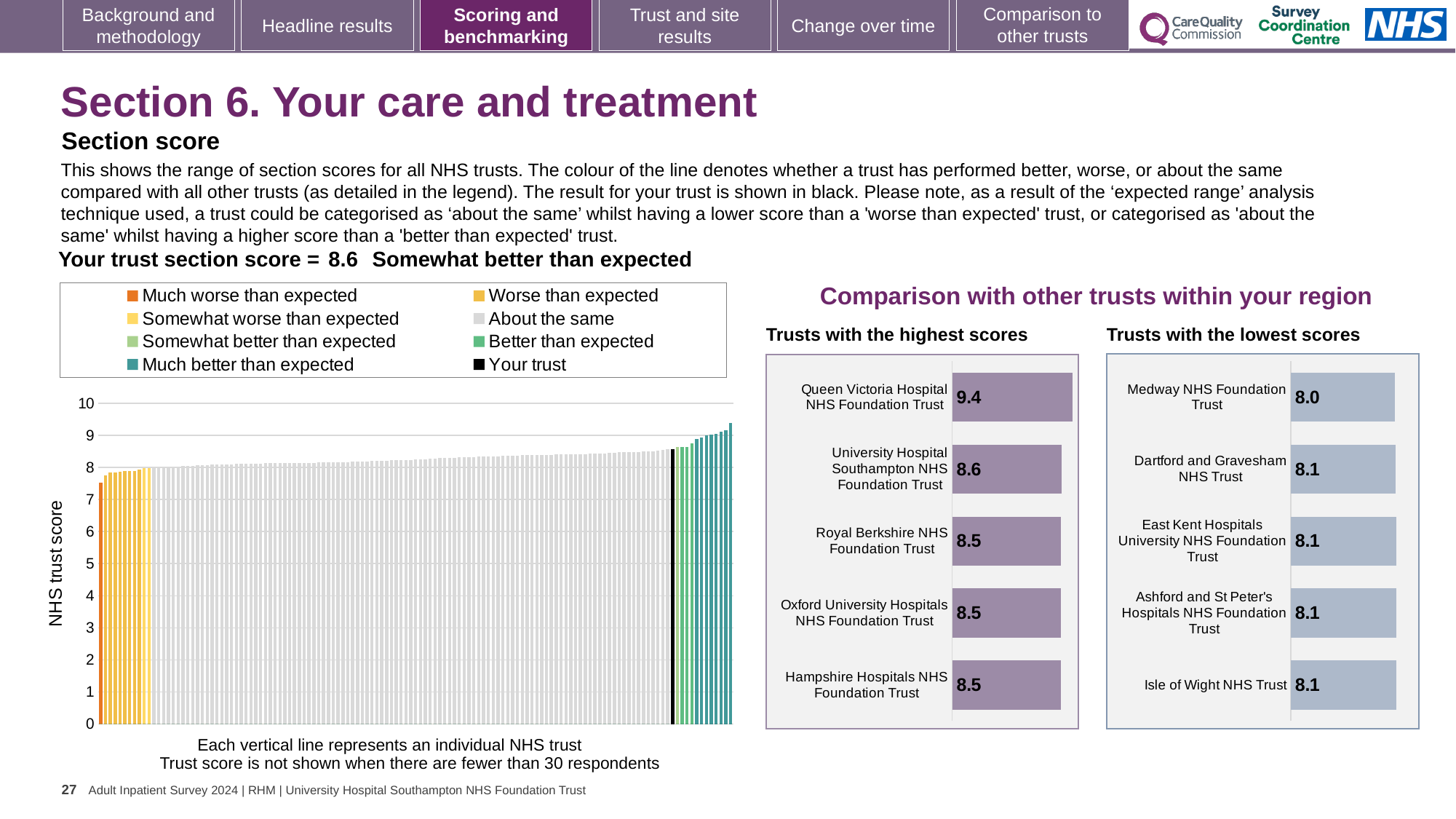
In the 'Trusts with the highest scores' chart, which trust has the highest score? Queen Victoria Hospital NHS Foundation Trust In the 'Trusts with the highest scores' chart, what is the score for Queen Victoria Hospital NHS Foundation Trust? 9.4 In the 'Trusts with the lowest scores' chart, which trust has the lowest score? Medway NHS Foundation Trust How many entries does the legend of the large chart on the left list? 8 In the large chart on the left, do the bar values rise or fall from left to right along the x axis? rise In the large chart on the left, is the value of the highest (rightmost) bar greater or less than 9? greater How many trusts are listed in the 'Trusts with the highest scores' chart? 5 In the 'Trusts with the lowest scores' chart, what is the difference between the scores of Isle of Wight NHS Trust and Medway NHS Foundation Trust? 0.1 In the 'Trusts with the highest scores' chart, what is the score for University Hospital Southampton NHS Foundation Trust? 8.6 In the 'Trusts with the lowest scores' chart, what is the score for Medway NHS Foundation Trust? 8.0 In the large chart on the left, is the value of the lowest (leftmost) bar greater or less than 8? less In the 'Trusts with the highest scores' chart, what is the difference between the scores of Queen Victoria Hospital NHS Foundation Trust and University Hospital Southampton NHS Foundation Trust? 0.8